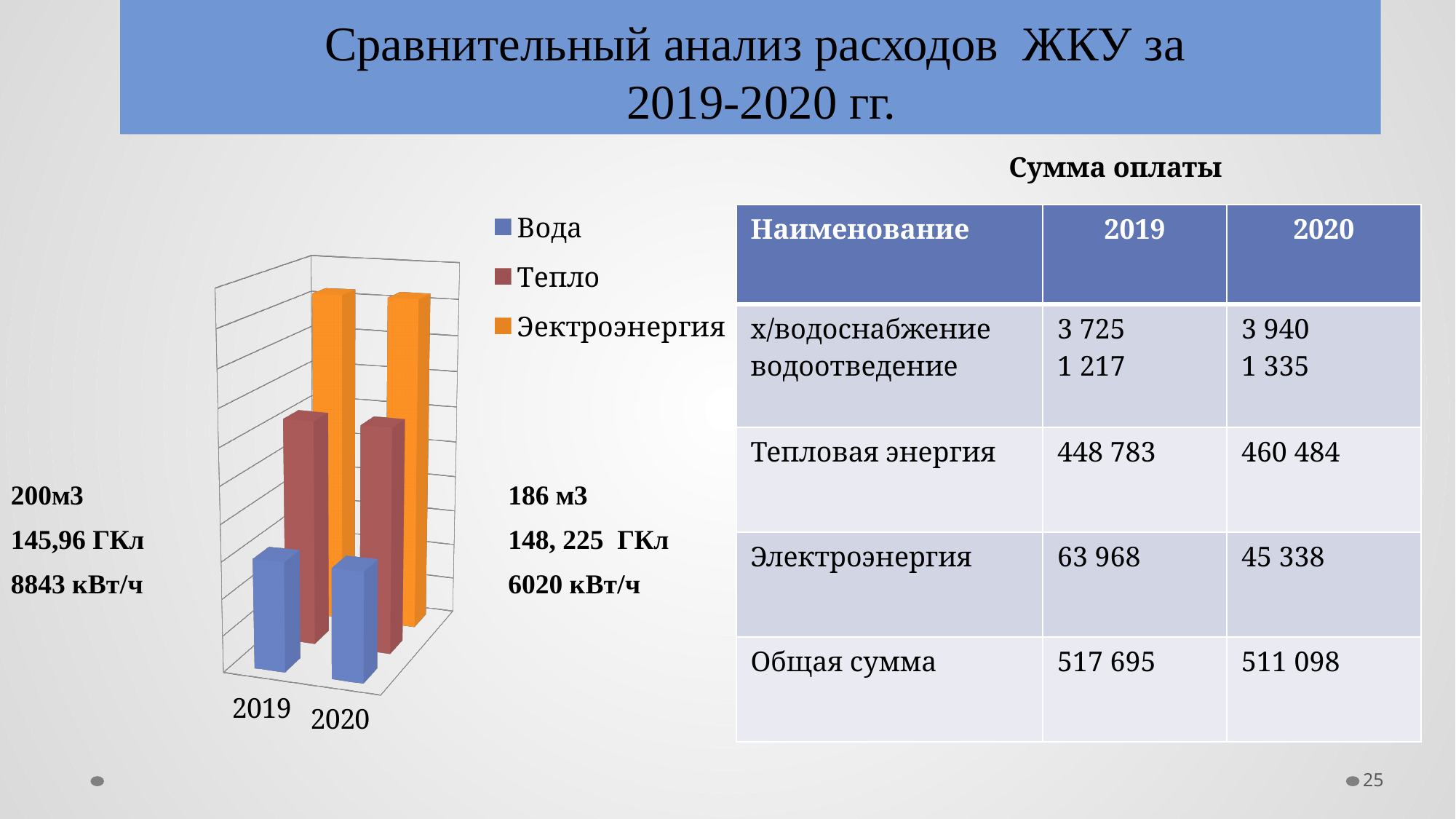
How many series does the chart legend list? 3 What kind of chart is shown on the slide? bar chart For 2019, which bar is taller: Эектроэнергия or Тепло? Эектроэнергия Which series has the shortest bar for 2020? Вода Which series has the shortest bar for 2019? Вода Which series are listed in the chart legend? Вода, Тепло, Эектроэнергия For 2020, which bar is taller: Тепло or Вода? Тепло Which series has the tallest bar for 2019? Эектроэнергия How many categories (years) are shown on the chart's x axis? 2 What colour are the bars for the Вода series? blue Which series has the tallest bar for 2020? Эектроэнергия Which years are labelled on the chart's x axis? 2019 and 2020